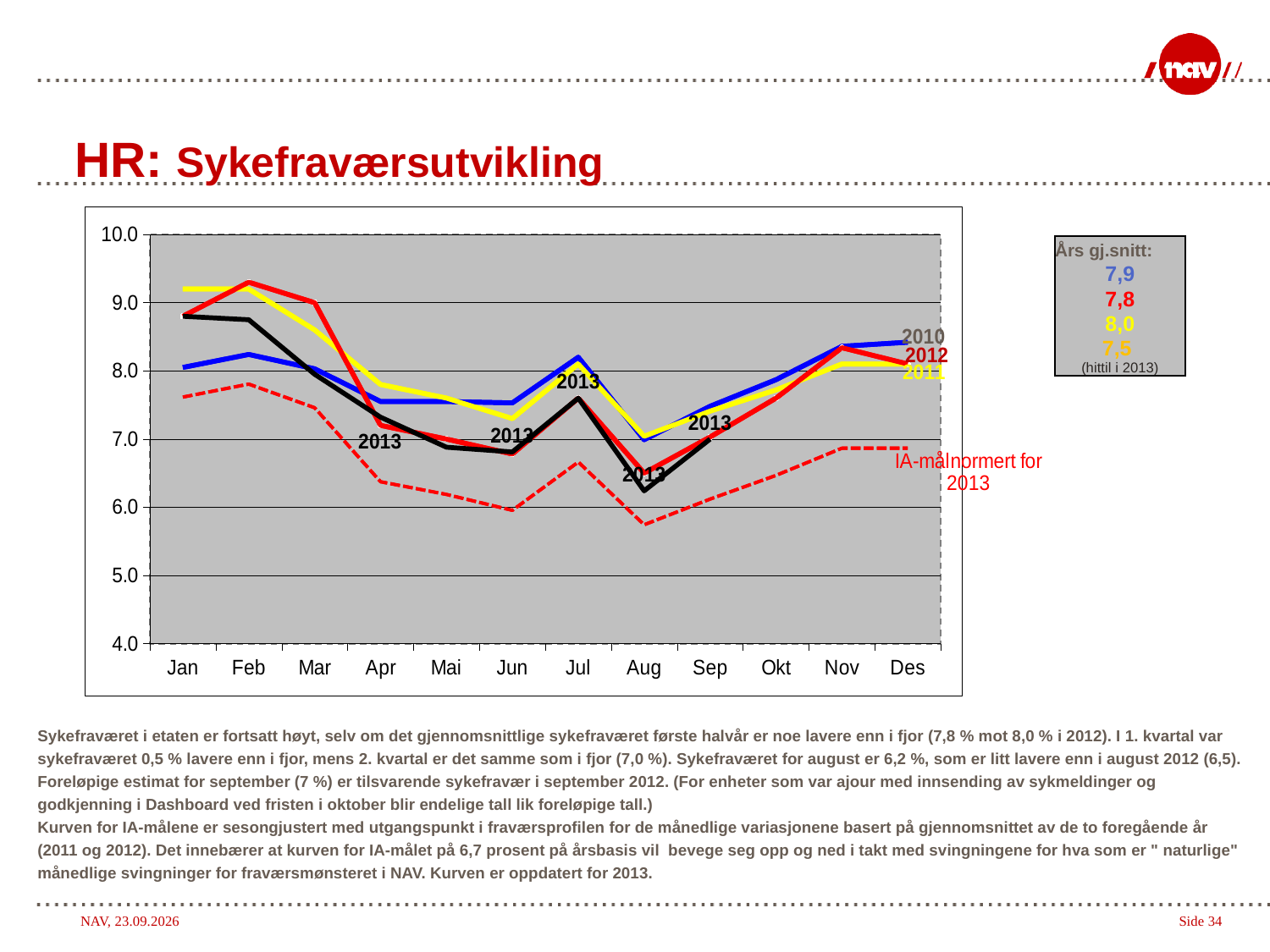
What is the title of the slide containing the chart? HR: Sykefraværsutvikling What is the label on the dashed red line in the chart? IA-mål normert for 2013 What kind of chart is shown on the slide? line chart In which month does the red 2012 line reach its highest value? Feb How many months are shown along the x axis of the chart? 12 In which month does the black 2013 line reach its lowest value? Aug Is the value of the black 2013 line in Aug greater or less than 7.0? less Is the value of the black 2013 line in Jan greater or less than 8.0? greater Is the value of the dashed red IA-mål line in Aug greater or less than 6.0? less Does the black 2013 line rise or fall from Jan to Jun? fall In Aug, which line is higher: the blue 2010 line or the black 2013 line? blue 2010 line